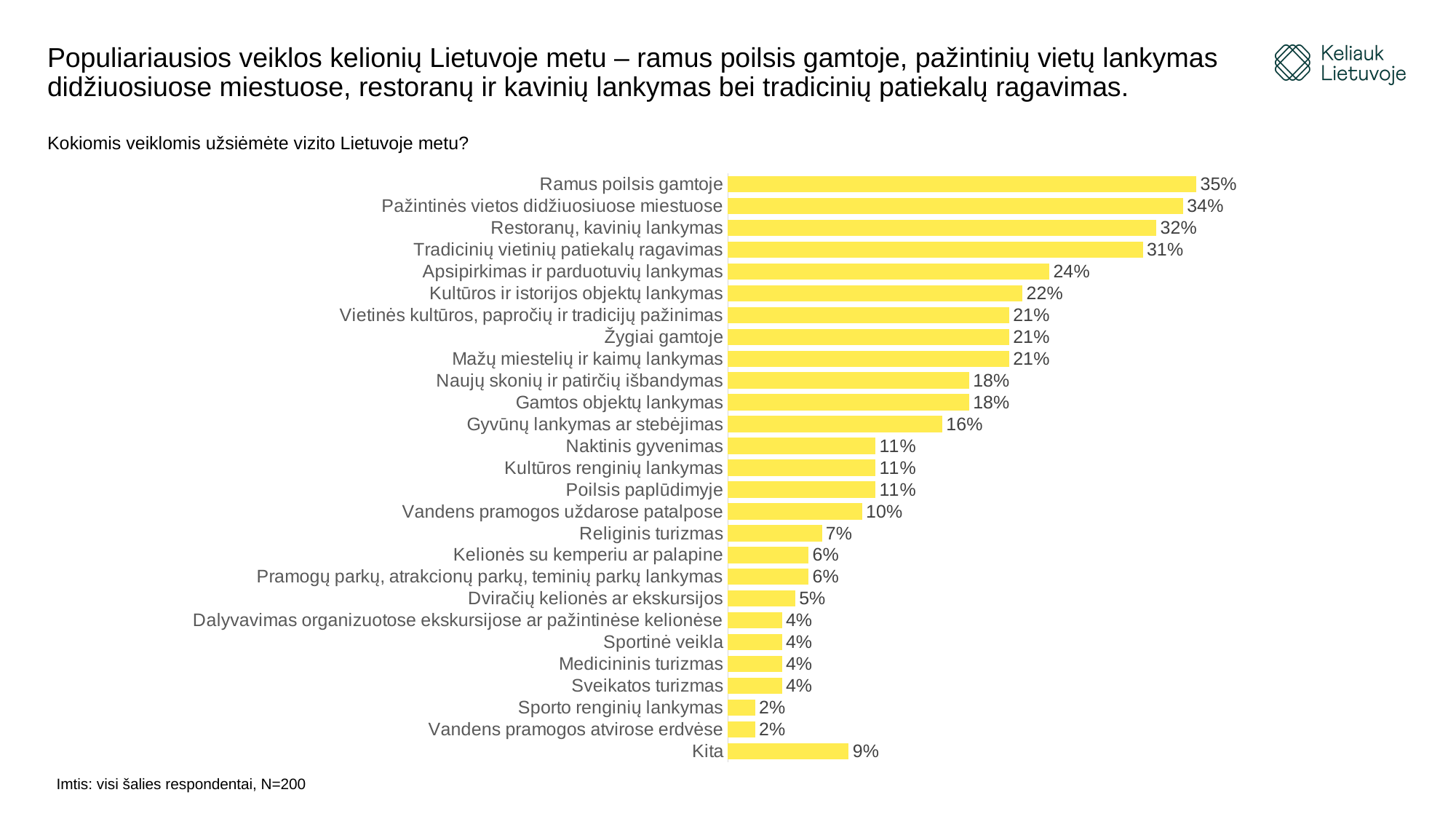
What is the difference between the values for "Apsipirkimas ir parduotuvių lankymas" and "Gyvūnų lankymas ar stebėjimas"? 8% What is the lowest percentage value shown in the chart? 2% What type of chart is shown on the slide? Bar chart Which has a larger value: "Kita" or "Dviračių kelionės ar ekskursijos"? Kita What is the difference between the values for "Ramus poilsis gamtoje" and "Pažintinės vietos didžiuosiuose miestuose"? 1% What percentage of respondents chose "Ramus poilsis gamtoje"? 35% What colour are the bars in the chart? Yellow Which has a larger value: "Naktinis gyvenimas" or "Religinis turizmas"? Naktinis gyvenimas What is the value shown for "Religinis turizmas"? 7% How many activity categories are shown in the chart? 27 What is the value shown for "Kita"? 9% Which activity has the highest percentage in the chart? Ramus poilsis gamtoje